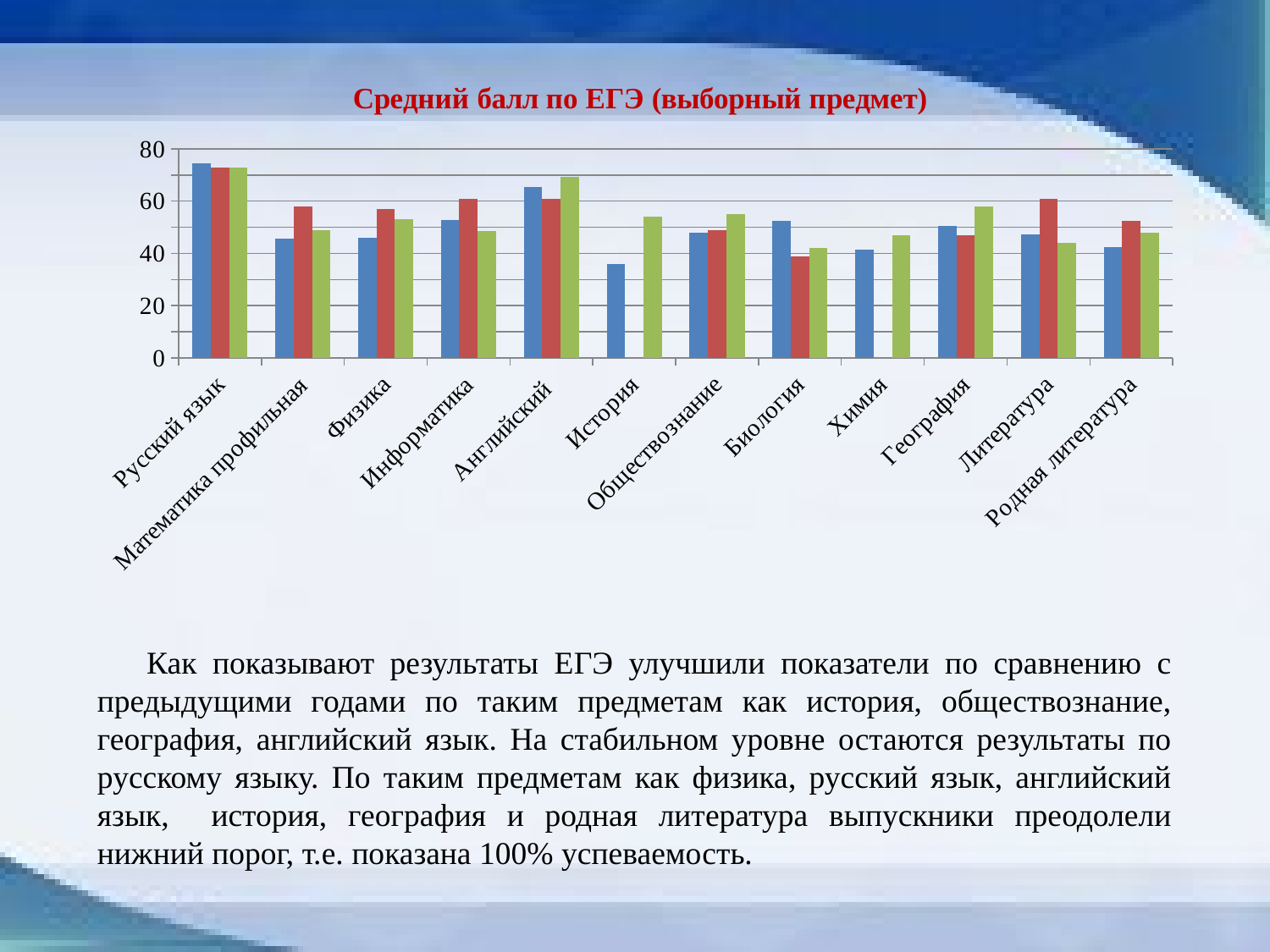
Which subject has the shortest blue bar in the chart? История Is the blue bar for Математика профильная greater or less than 60? less Is the blue bar for Русский язык greater or less than 60? greater How many subject categories are shown on the x axis of the chart? 12 Which is larger: the blue bar for Русский язык or the blue bar for История? Русский язык Is the green bar for Английский greater or less than 60? greater Which is larger: the green bar for Английский or the green bar for Биология? Английский What kind of chart is shown on the slide? bar chart Which subject has the tallest blue bar in the chart? Русский язык What is the title of the chart? Средний балл по ЕГЭ (выборный предмет) How many bar colours (series) are plotted in the chart? 3